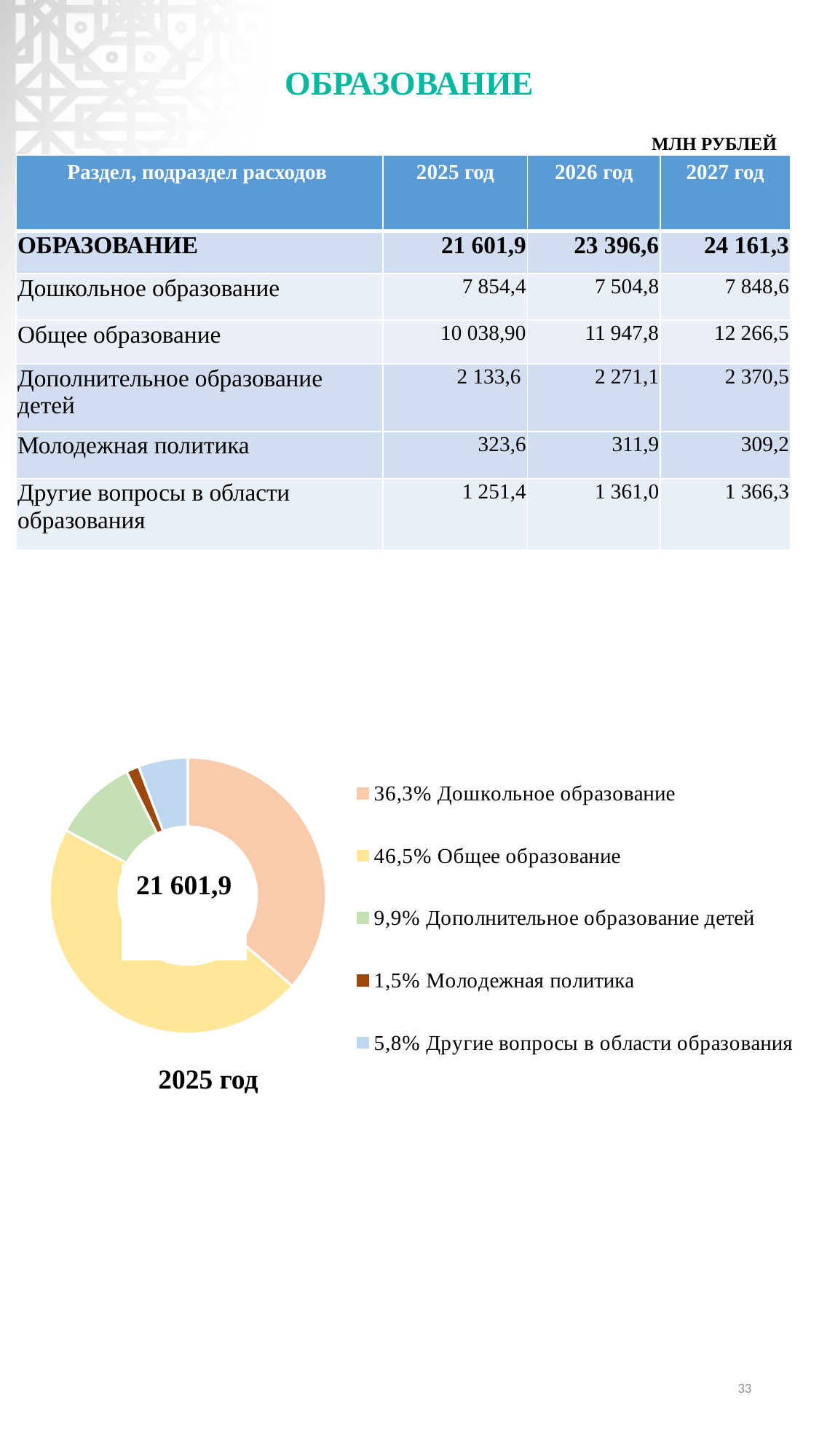
What share of the 2025 год doughnut chart is Общее образование? 46,5% What share of the 2025 год doughnut chart is Молодежная политика? 1,5% In the doughnut chart, which slice is larger: Дошкольное образование or Другие вопросы в области образования? Дошкольное образование How many categories does the legend of the doughnut chart list? 5 What share of the 2025 год doughnut chart is Дополнительное образование детей? 9,9% What total value is printed in the centre of the doughnut chart? 21 601,9 What kind of chart is shown on the slide? doughnut chart Which category has the largest slice in the 2025 год doughnut chart? Общее образование Which category has the smallest slice in the 2025 год doughnut chart? Молодежная политика What year is the doughnut chart labelled with? 2025 год